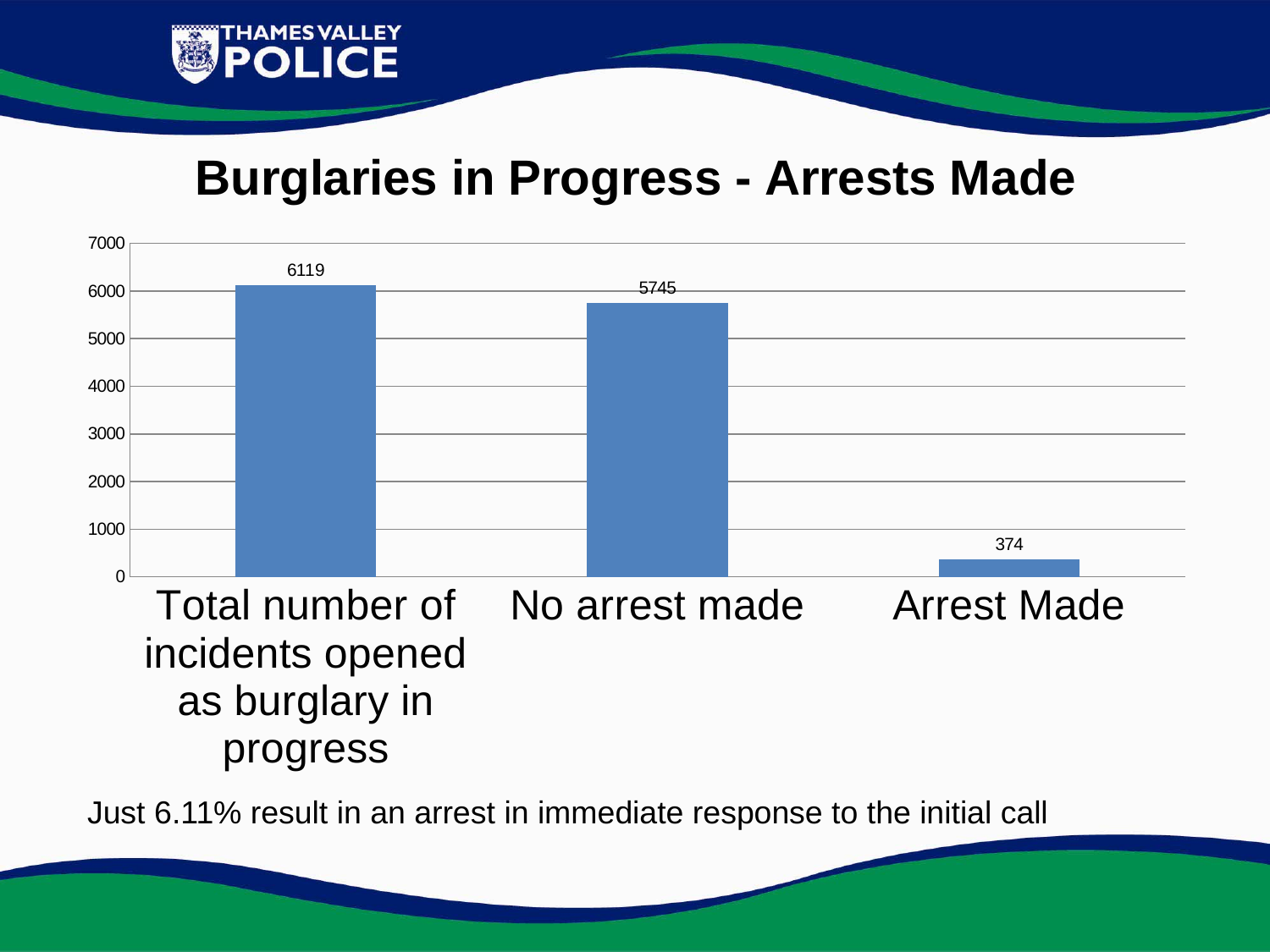
How many categories are shown on the chart? 3 What is the value for "Total number of incidents opened as burglary in progress"? 6119 What is the value for "Arrest Made"? 374 Which category has the highest value? Total number of incidents opened as burglary in progress Which is larger, "No arrest made" or "Arrest Made"? No arrest made Which category has the lowest value? Arrest Made What is the difference between "No arrest made" and "Arrest Made"? 5371 What is the difference between the total number of incidents and "No arrest made"? 374 What is the value for "No arrest made"? 5745 What kind of chart is shown on the slide? Bar chart What is the title of the chart? Burglaries in Progress - Arrests Made Is the value for "Arrest Made" greater or less than 1000? less